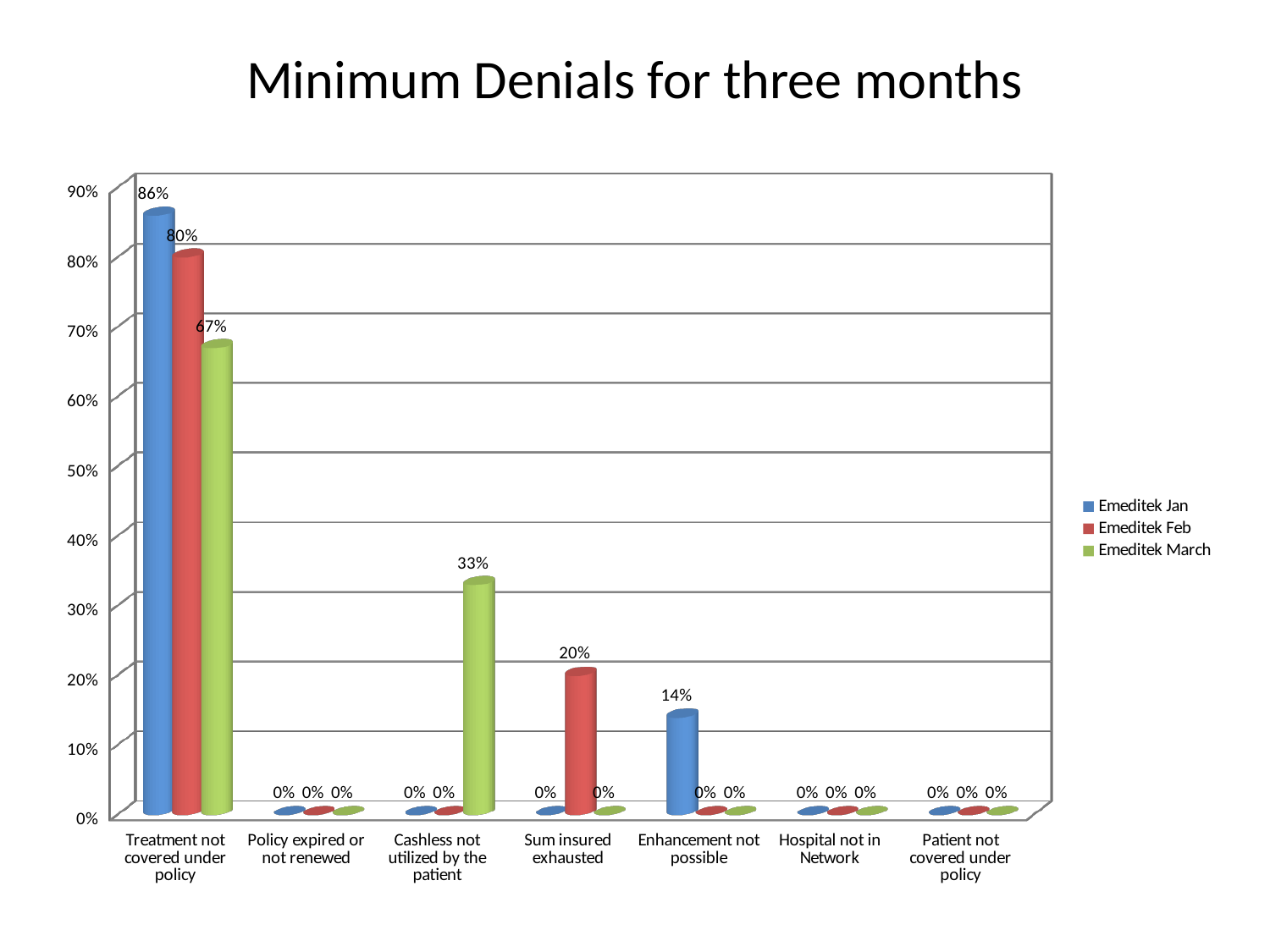
What is the Emeditek Feb value for Sum insured exhausted? 20% Which is larger for Treatment not covered under policy: the Emeditek Feb value or the Emeditek March value? Emeditek Feb What is the difference between the Emeditek Jan and Emeditek March values for Treatment not covered under policy? 19% What is the Emeditek Jan value for Enhancement not possible? 14% What kind of chart is shown on the slide? Bar chart What is the title of the chart? Minimum Denials for three months Which category has the highest Emeditek March value? Treatment not covered under policy What is the Emeditek March value for Cashless not utilized by the patient? 33% What is the Emeditek Jan value for Treatment not covered under policy? 86% How many series does the legend list? 3 How many categories are shown on the x axis? 7 What is the Emeditek Feb value for Treatment not covered under policy? 80%